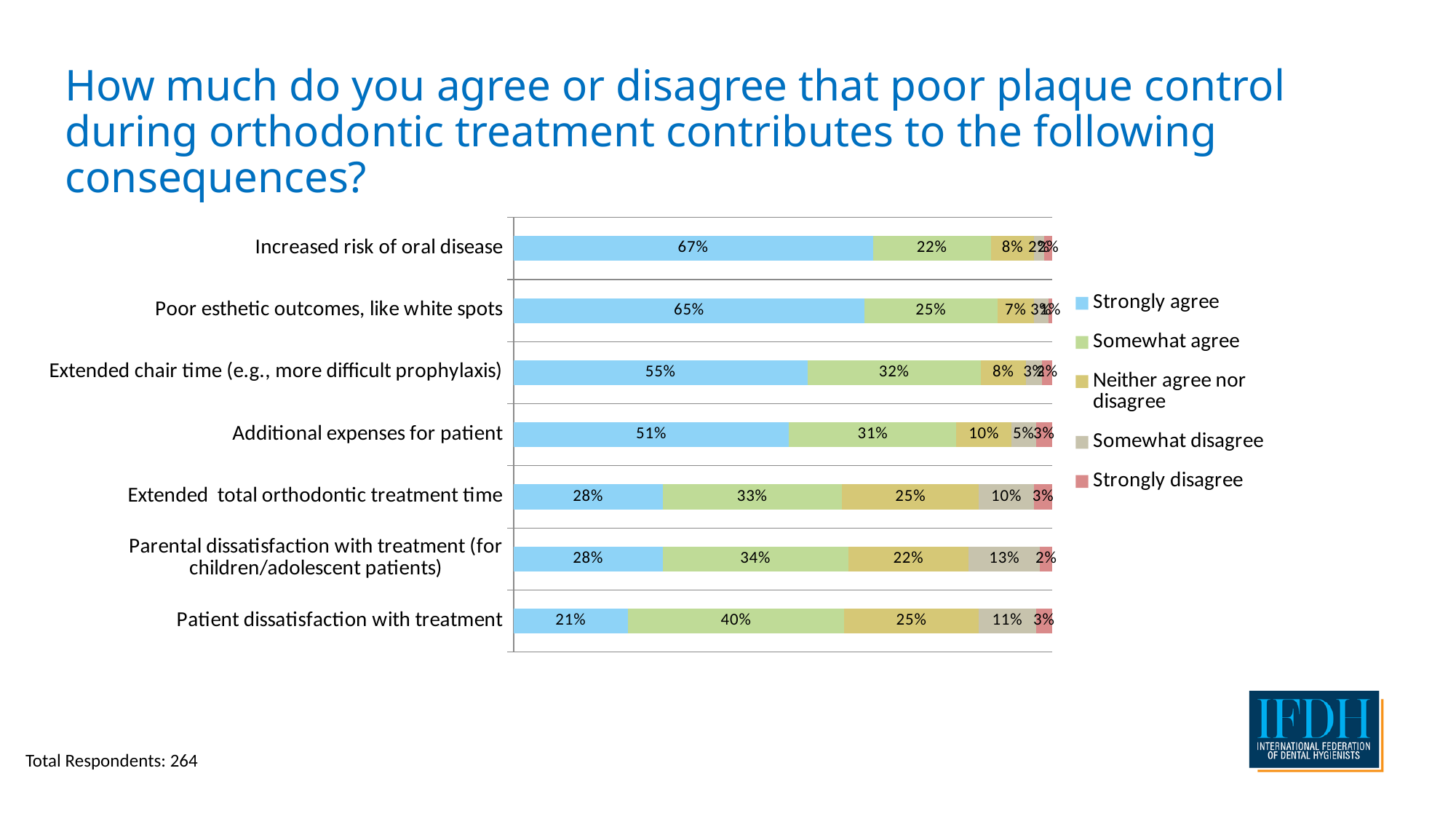
What is the Neither agree nor disagree value for Extended total orthodontic treatment time? 25% What percentage of respondents strongly agree that poor plaque control contributes to increased risk of oral disease? 67% What is the total of the stacked bar for Patient dissatisfaction with treatment? 100% Which has a larger Strongly agree value: Extended chair time (e.g., more difficult prophylaxis) or Additional expenses for patient? Extended chair time (e.g., more difficult prophylaxis) Which consequence has the lowest Strongly agree percentage? Patient dissatisfaction with treatment Which consequence has the highest Strongly agree percentage? Increased risk of oral disease What is the Somewhat agree value for Patient dissatisfaction with treatment? 40% What kind of chart is shown on the slide? Stacked bar chart What is the Somewhat disagree value for Parental dissatisfaction with treatment (for children/adolescent patients)? 13% What is the difference between the Strongly agree values for Increased risk of oral disease and Poor esthetic outcomes, like white spots? 2 percentage points How many series does the legend list? 5 How many consequences (categories) are shown in the chart? 7